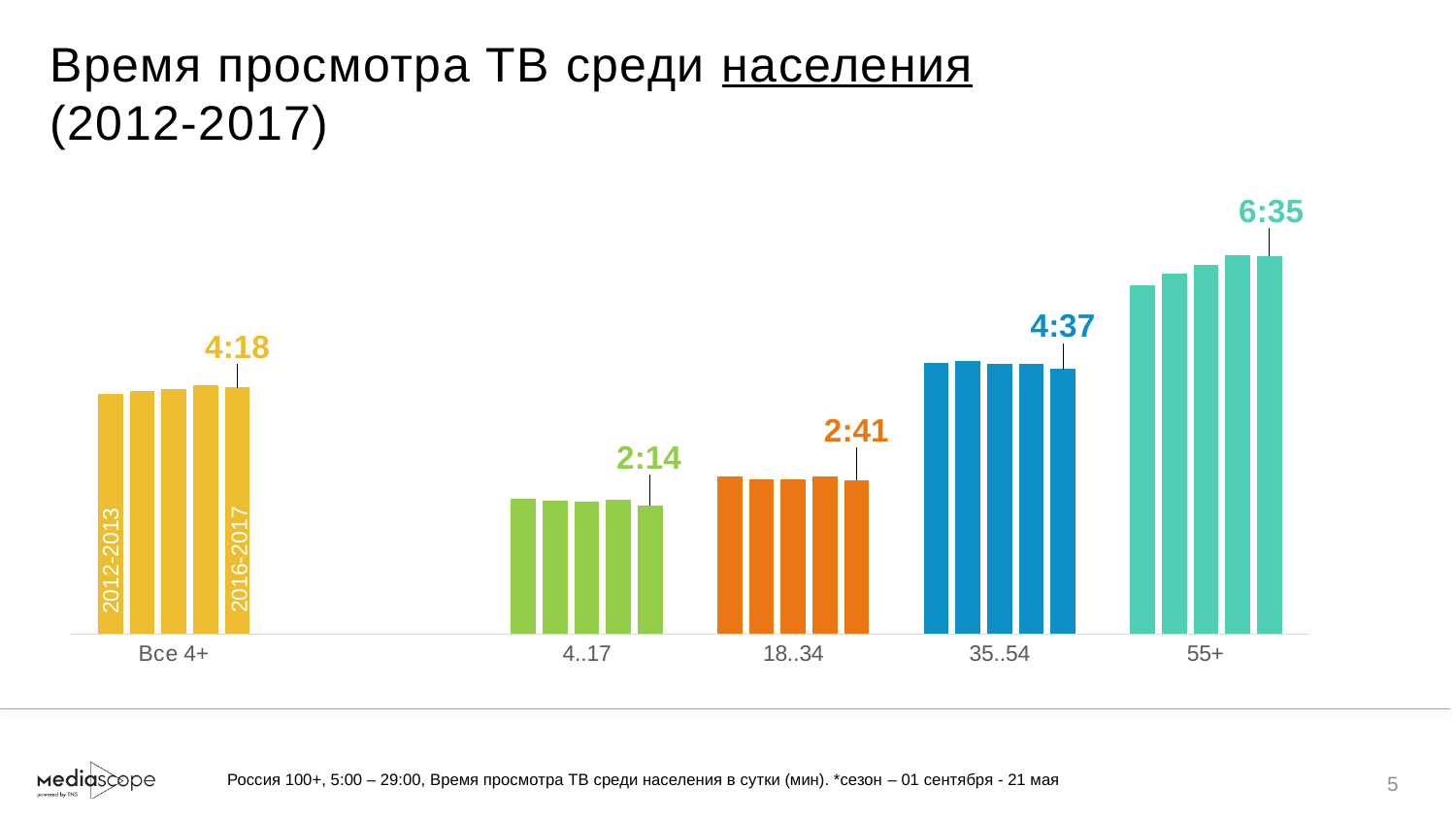
What kind of chart is shown on the slide? Bar chart How many bars (seasons) are shown for each age group? 5 What is the TV viewing time for the 2016-2017 season in the 35..54 group? 4:37 What is the title of the chart on the slide? Время просмотра ТВ среди населения (2012-2017) What is the TV viewing time for the 2016-2017 season in the Все 4+ group? 4:18 Which age group has the lowest TV viewing time in the 2016-2017 season? 4..17 In the 2016-2017 season, which group has the larger viewing time: 18..34 or 4..17? 18..34 What is the TV viewing time for the 2016-2017 season in the 4..17 group? 2:14 Which age group has the highest TV viewing time in the 2016-2017 season? 55+ How many age groups are shown on the x axis? 5 In the 55+ group, do the bars rise or fall from the 2012-2013 season to the 2016-2017 season? Rise What is the TV viewing time for the 2016-2017 season in the 55+ group? 6:35